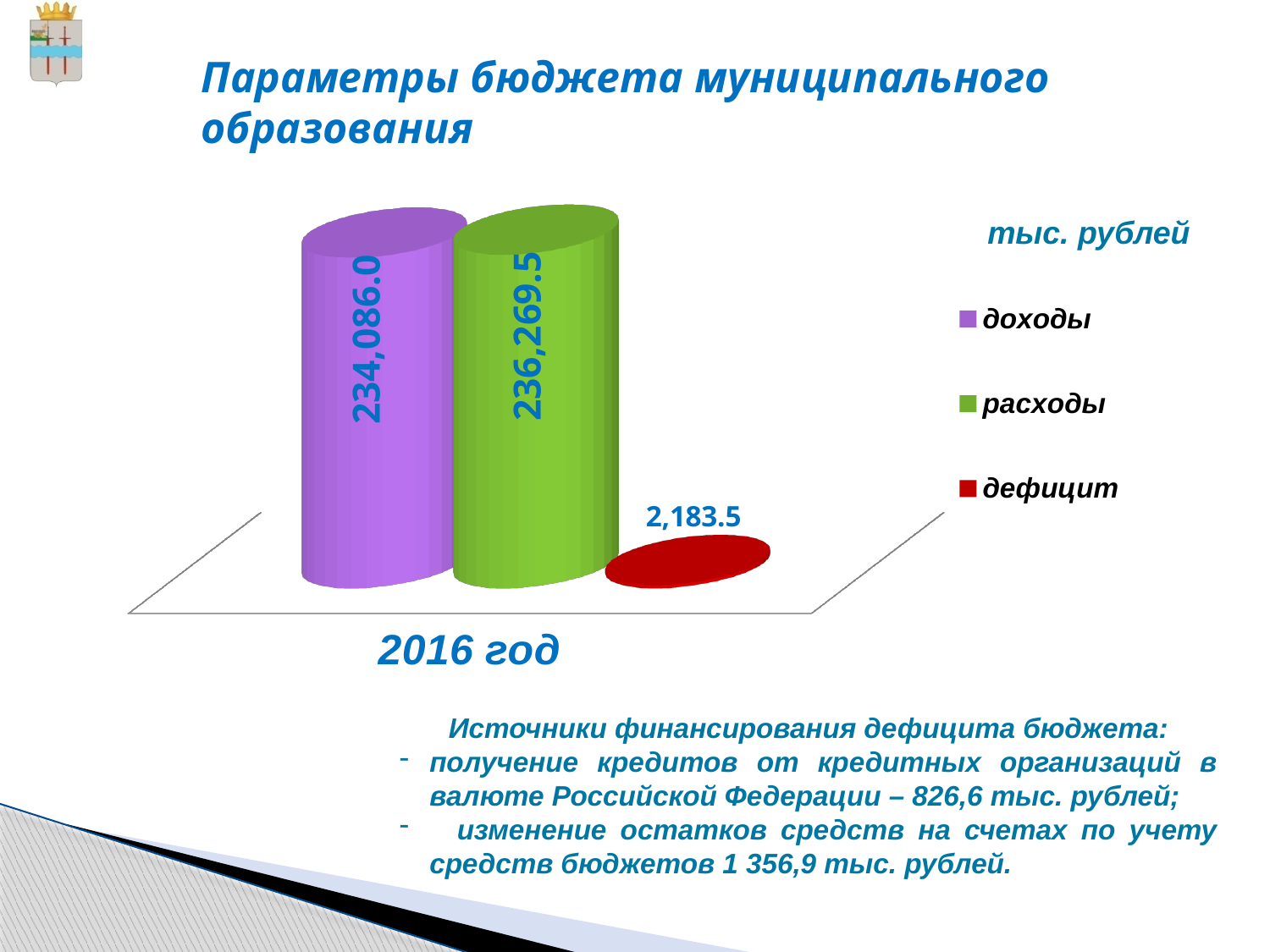
What is the value for доходы in 2016 год? 234,086.0 What is the difference between расходы and доходы? 2,183.5 What unit is indicated for the chart values? тыс. рублей What kind of chart is shown on the slide? bar chart What is the value for дефицит in 2016 год? 2,183.5 What is the value for расходы in 2016 год? 236,269.5 Which series has the highest value in the chart? расходы What colour represents дефицит in the chart? red Which is larger, доходы or расходы? расходы Which series has the lowest value in the chart? дефицит How many series does the legend list? 3 How many categories are shown on the x axis? 1